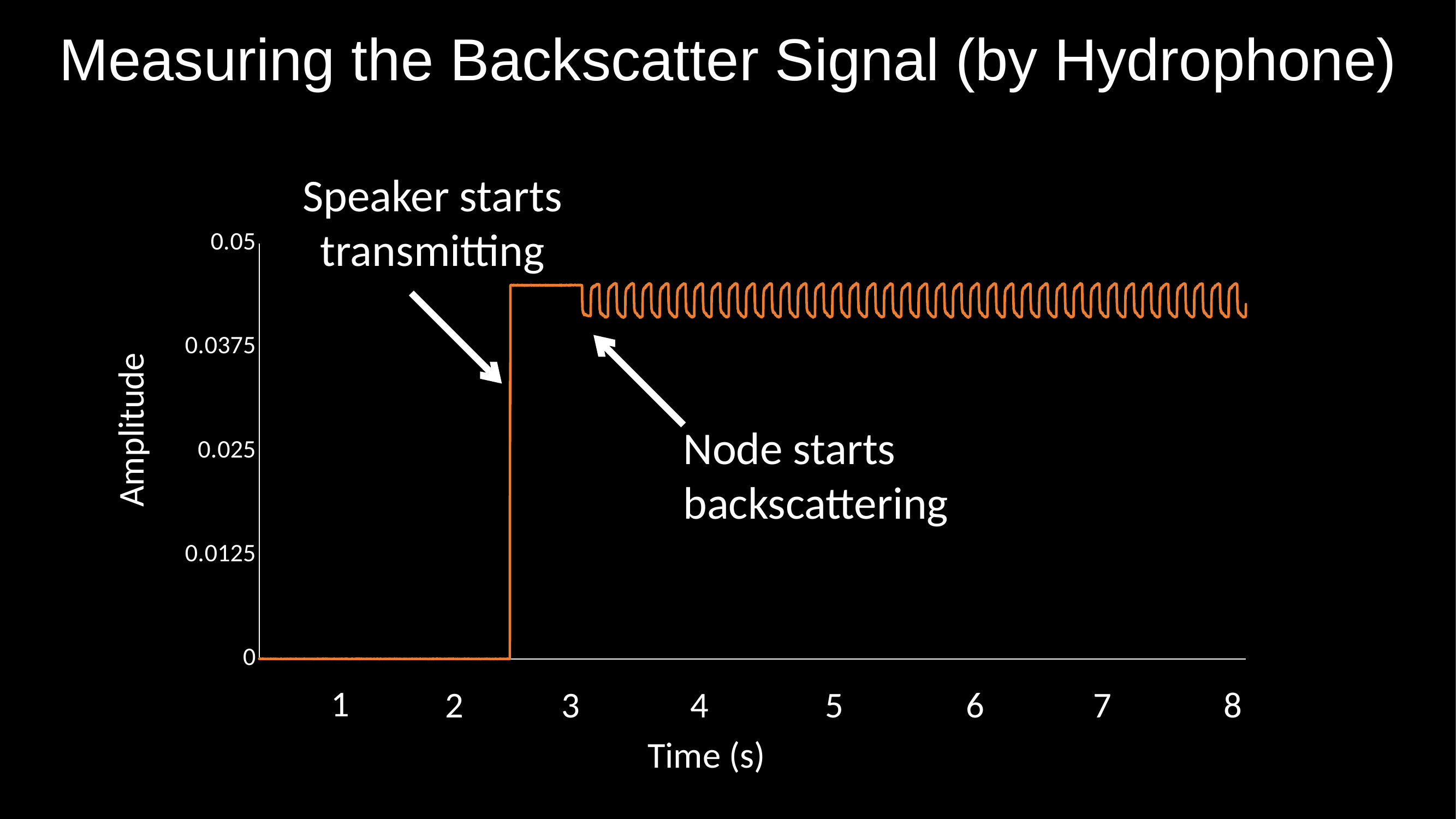
What is the title of the slide's chart? Measuring the Backscatter Signal (by Hydrophone) Does the amplitude rise or fall between time 2 s and time 3 s? rise Is the amplitude at time 4 s greater or less than 0.0375? greater What is the label of the y axis? Amplitude What is the highest value shown on the x axis? 8 What kind of chart is shown on the slide? line chart Is the amplitude at time 2 s greater or less than 0.025? less Is the amplitude at time 1 s greater or less than 0.0125? less Which is larger, the amplitude at time 1 s or the amplitude at time 5 s? time 5 s